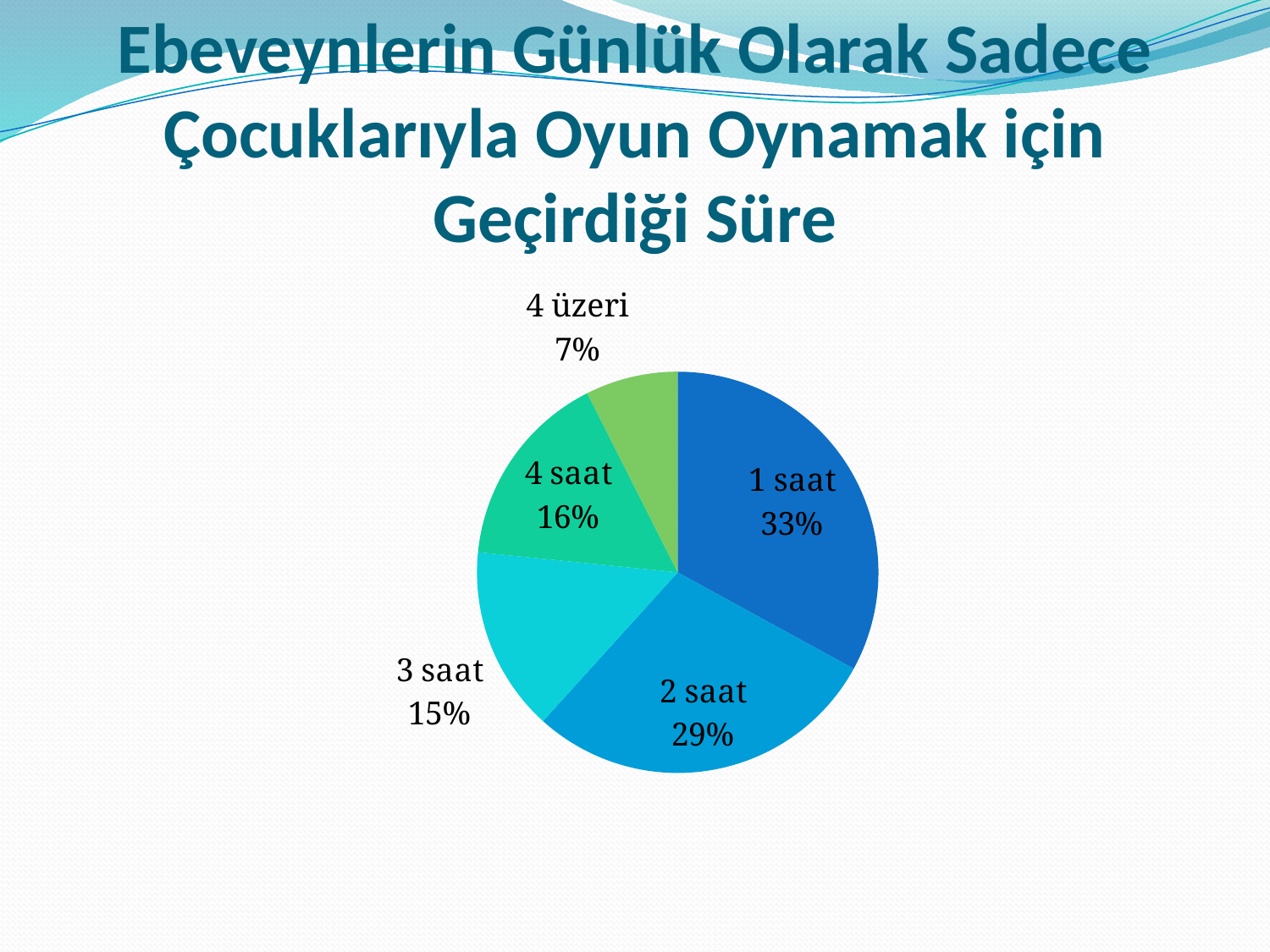
Which category has the smallest slice of the pie? 4 üzeri What is the difference in percentage points between "1 saat" and "2 saat"? 4 What kind of chart is shown on the slide? Pie chart Which is larger, the value for "4 saat" or the value for "3 saat"? 4 saat What share of the pie does the "1 saat" slice represent? 33% What is the title of the slide containing the chart? Ebeveynlerin Günlük Olarak Sadece Çocuklarıyla Oyun Oynamak için Geçirdiği Süre What is the value shown for "4 saat"? 16% What is the value shown for "4 üzeri"? 7% What is the value shown for "2 saat"? 29% Which category has the largest slice of the pie? 1 saat What is the value shown for "3 saat"? 15% How many slices does the pie chart have? 5